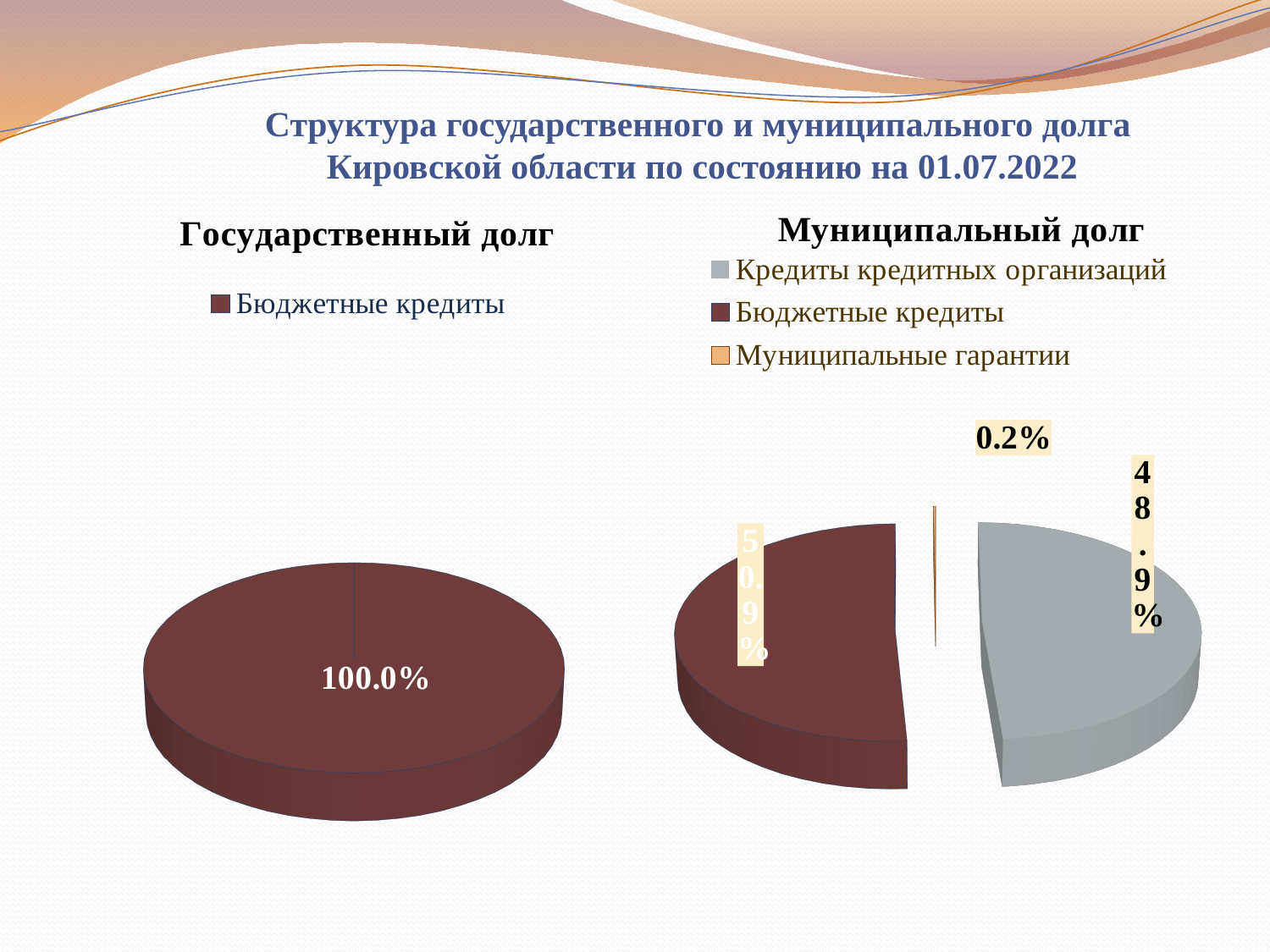
What type of chart is used for "Муниципальный долг"? pie chart How many entries does the legend of the "Государственный долг" chart list? 1 In the "Муниципальный долг" chart, what share does "Кредиты кредитных организаций" have? 48.9% In the "Муниципальный долг" chart, what is the difference between the shares of "Кредиты кредитных организаций" and "Муниципальные гарантии"? 48.7% What type of chart is used for "Государственный долг"? pie chart What is the title of the slide above the two charts? Структура государственного и муниципального долга Кировской области по состоянию на 01.07.2022 In the "Муниципальный долг" chart, what is the difference between the shares of "Бюджетные кредиты" and "Кредиты кредитных организаций"? 2.0% How many entries does the legend of the "Муниципальный долг" chart list? 3 In the "Государственный долг" chart, what share does "Бюджетные кредиты" have? 100.0% In the "Муниципальный долг" chart, which category has the smallest share? Муниципальные гарантии In the "Муниципальный долг" chart, what share does "Муниципальные гарантии" have? 0.2%